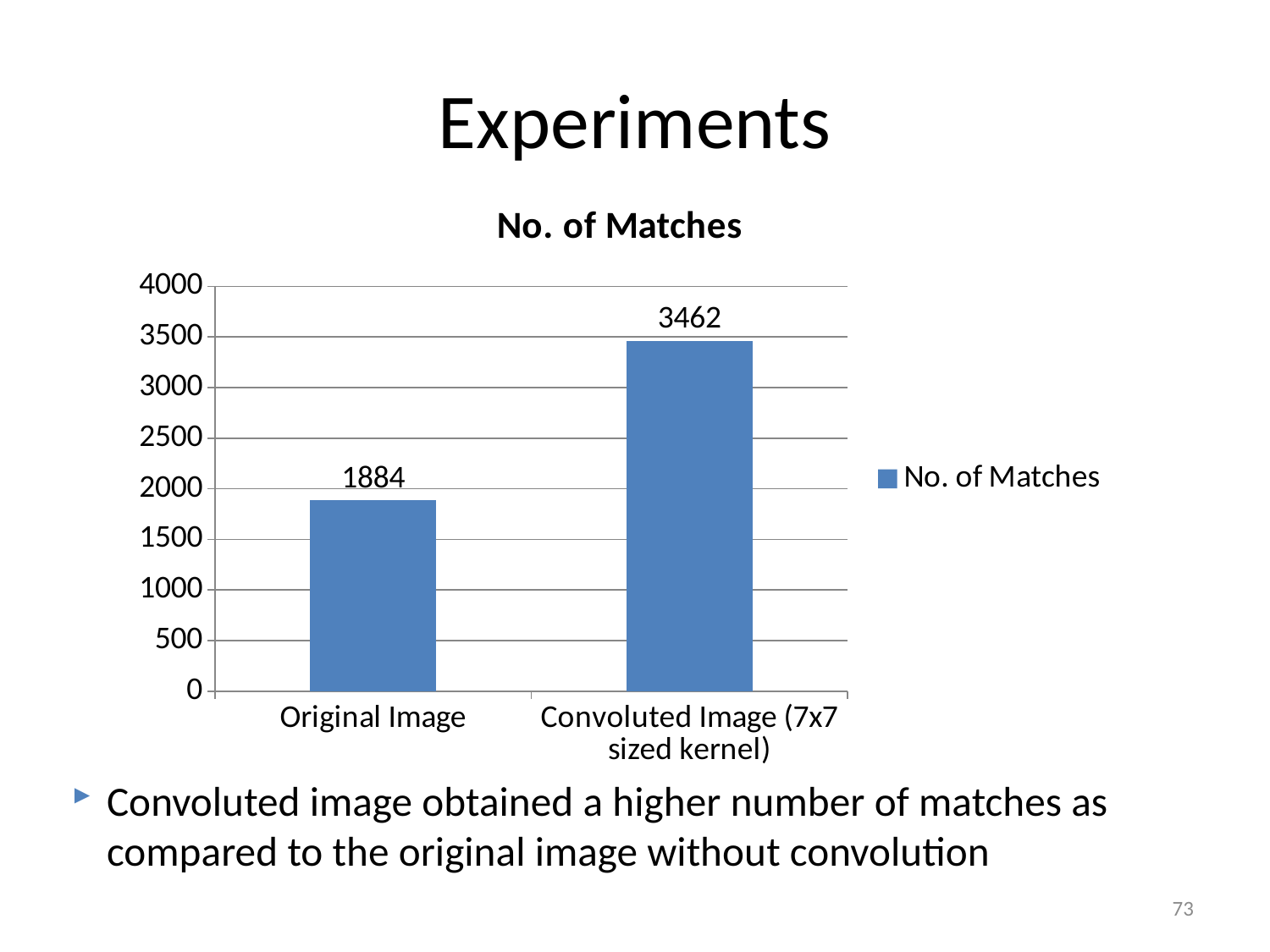
What is the number of matches for the Original Image? 1884 How many series does the legend list? 1 Is the value for the Convoluted Image (7x7 sized kernel) greater or less than 3000? greater Which category has the highest number of matches? Convoluted Image (7x7 sized kernel) What kind of chart is shown on the slide? Bar chart How many categories are shown on the x axis of the chart? 2 Is the value for the Original Image greater or less than 2000? less What is the title of the chart? No. of Matches What is the difference in number of matches between the Convoluted Image (7x7 sized kernel) and the Original Image? 1578 What is the number of matches for the Convoluted Image (7x7 sized kernel)? 3462 Which has more matches, the Original Image or the Convoluted Image (7x7 sized kernel)? Convoluted Image (7x7 sized kernel) Which category has the lowest number of matches? Original Image